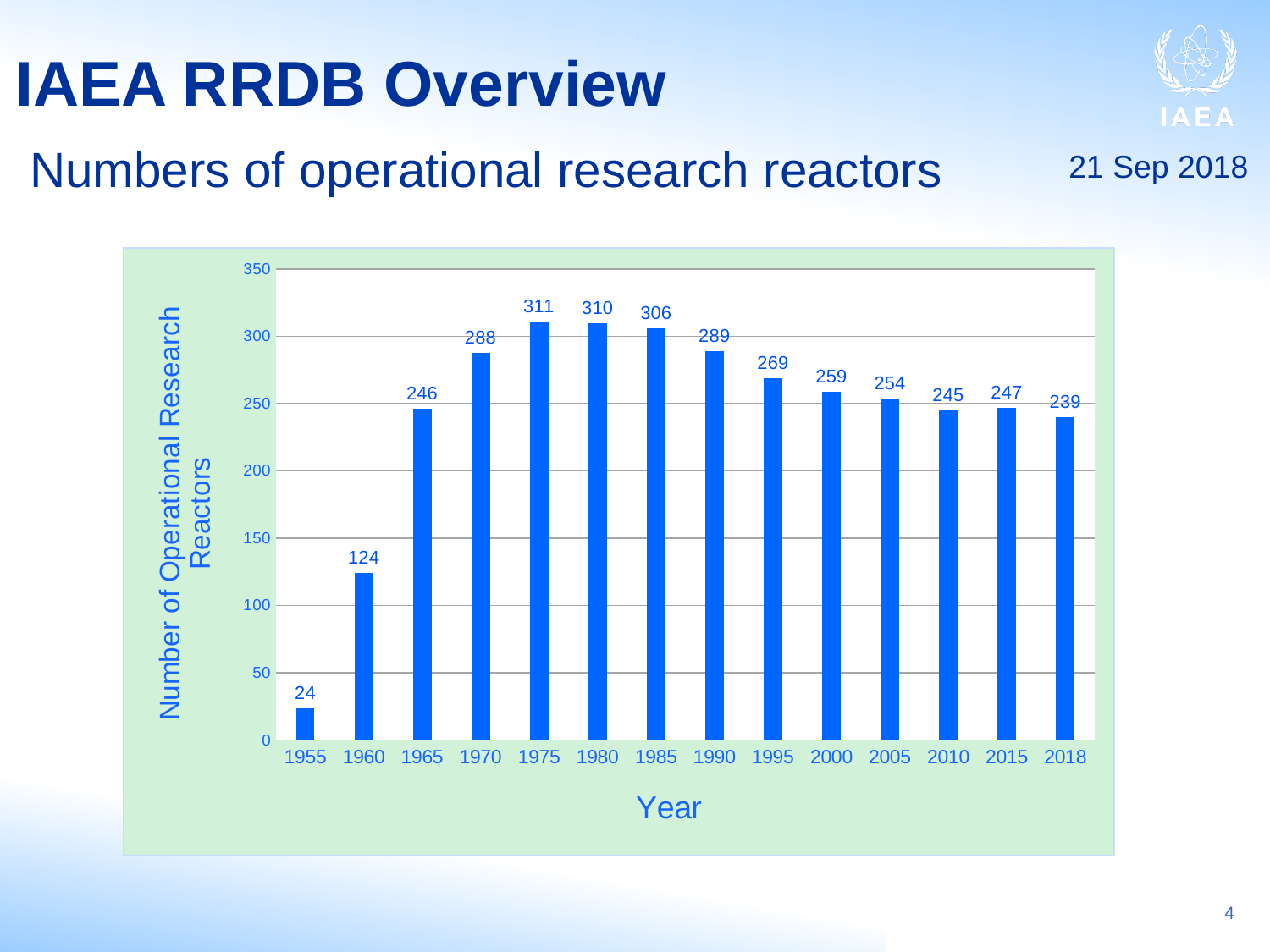
What is the number of operational research reactors in 2018? 239 Which year has the lowest number of operational research reactors? 1955 How many years are shown on the x axis of the chart? 14 What is the difference between the number of operational research reactors in 1975 and in 2018? 72 Is the number of operational research reactors in 1965 greater or less than 200? greater Which year has more operational research reactors, 1990 or 2000? 1990 What is the number of operational research reactors in 1975? 311 What kind of chart is shown on the slide? bar chart What is the difference between the number of operational research reactors in 1960 and in 1955? 100 What is the number of operational research reactors in 1955? 24 What is the label of the y axis of the chart? Number of Operational Research Reactors Which year has the highest number of operational research reactors? 1975